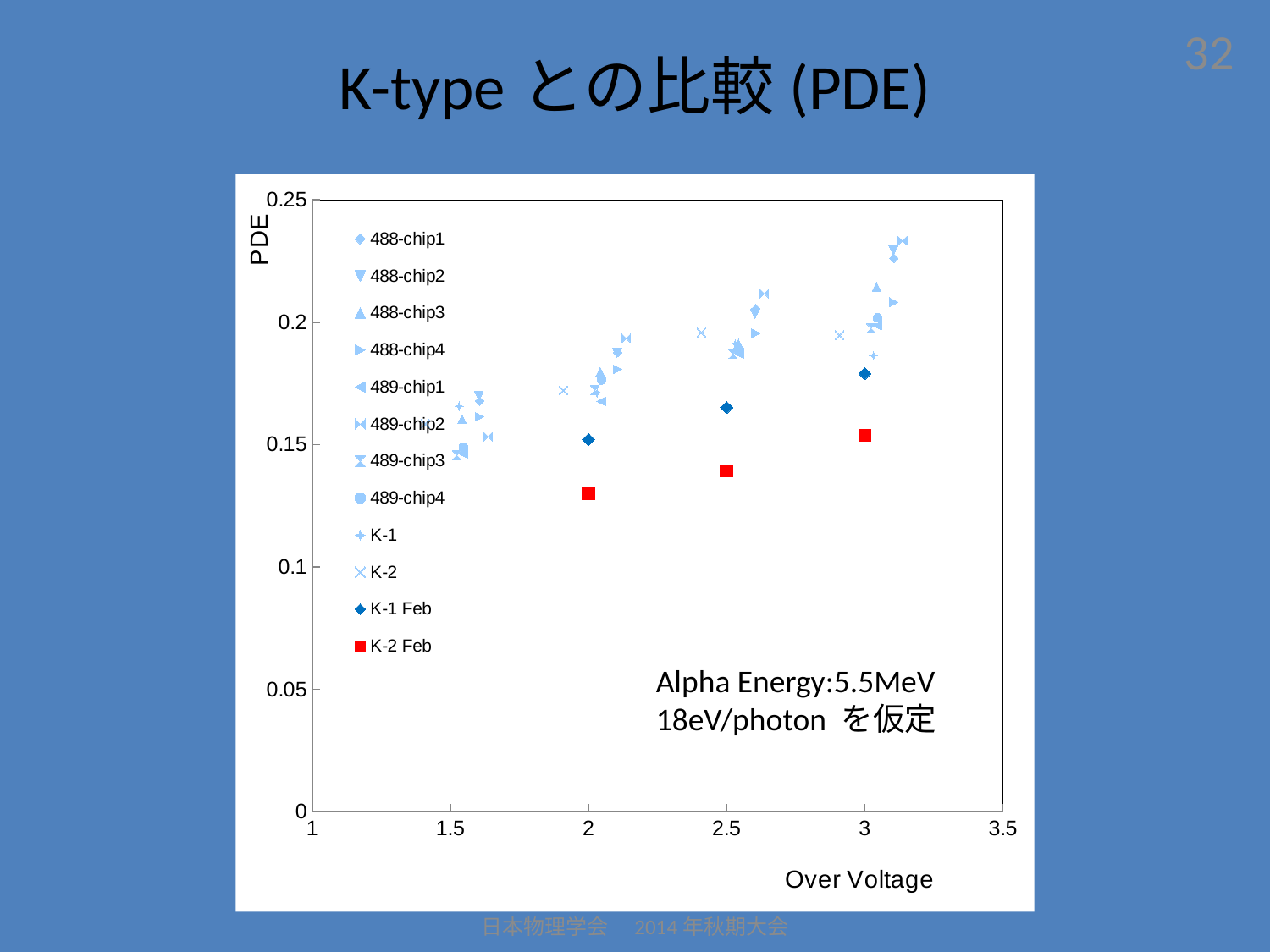
At an over voltage of 2, which series has the larger PDE, K-1 Feb or K-2 Feb? K-1 Feb What kind of chart is shown on the slide? scatter chart How many series does the legend list? 12 How many data points are plotted for the K-2 Feb series? 3 Is the value for K-1 Feb at an over voltage of 2.5 greater or less than 0.15? greater Do the K-1 Feb values rise or fall as over voltage increases? rise Do the K-2 Feb values rise or fall as over voltage increases? rise What is the label of the y axis? PDE Is the value for K-2 Feb at an over voltage of 2 greater or less than 0.15? less What is the label of the x axis? Over Voltage Is the value for K-2 Feb at an over voltage of 2.5 greater or less than 0.15? less